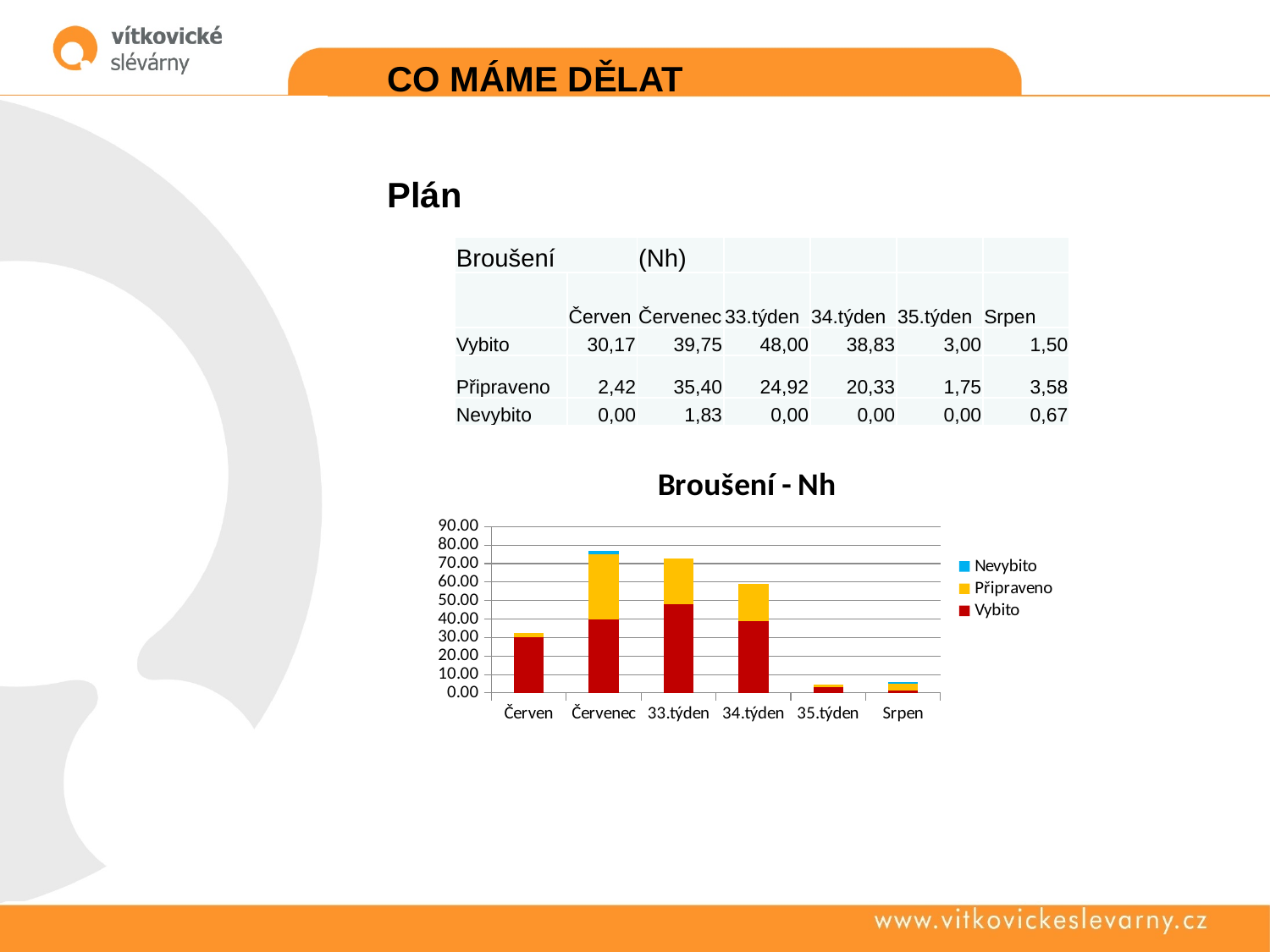
Which category has the lowest Vybito value in the "Broušení - Nh" chart? Srpen What is the Vybito value for 33.týden in the "Broušení - Nh" chart? 48,00 What is the Připraveno value for Červenec in the "Broušení - Nh" chart? 35,40 Which category has the highest Vybito value in the "Broušení - Nh" chart? 33.týden In the "Broušení - Nh" chart, is the total stacked value for 34.týden greater or less than 50? greater What is the Nevybito value for Srpen in the "Broušení - Nh" chart? 0,67 What kind of chart is shown under the title "Broušení - Nh"? stacked bar chart What is the total height of the stacked bar for Červenec in the "Broušení - Nh" chart? 76,98 In the "Broušení - Nh" chart, is the Připraveno value larger for Červenec or for 33.týden? Červenec What is the difference between the Vybito values for 33.týden and 34.týden in the "Broušení - Nh" chart? 9,17 How many series does the legend of the "Broušení - Nh" chart list? 3 How many categories are shown on the x axis of the "Broušení - Nh" chart? 6